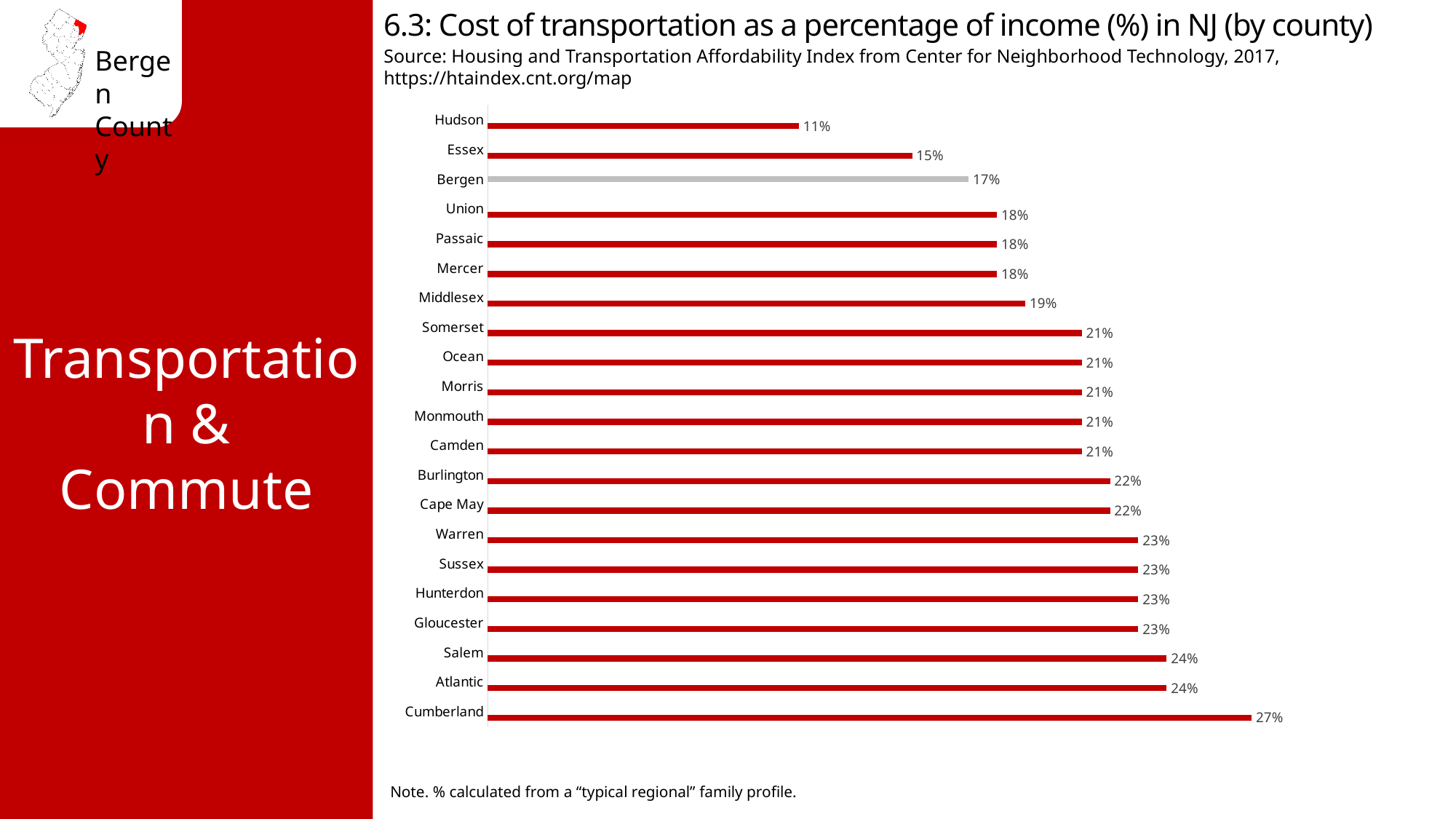
How many counties are shown in the chart? 21 What is the cost of transportation as a percentage of income for Bergen County? 17% Which county has the lowest cost of transportation as a percentage of income? Hudson Which has a higher value, Bergen or Essex? Bergen What kind of chart is shown on the slide? Bar chart Which has a higher value, Salem or Warren? Salem What is the value shown for Middlesex County? 19% What is the value shown for Hudson County? 11% Which county has the highest cost of transportation as a percentage of income? Cumberland What is the difference between the values for Cumberland and Bergen? 10% Which county's bar is shown in a different colour (grey) from the others? Bergen What is the difference between the values for Essex and Hudson? 4%